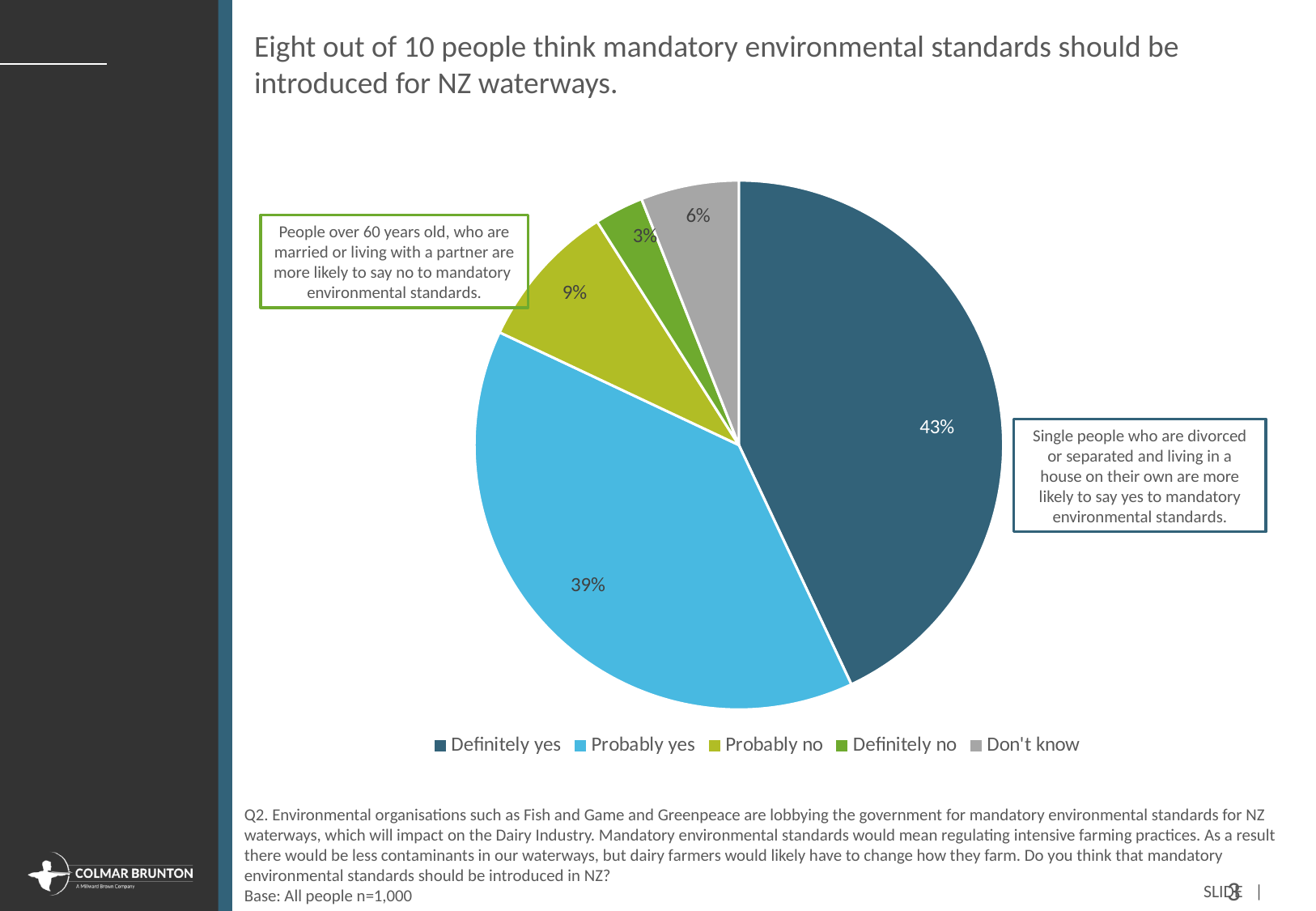
Which is larger: the share for 'Probably no' or the share for 'Don't know'? Probably no What percentage of people answered 'Don't know'? 6% Which response category has the largest share of the pie? Definitely yes How many response categories does the legend list? 5 What percentage of people said 'Probably yes'? 39% What percentage of people said 'Probably no'? 9% What is the difference in percentage points between 'Definitely yes' and 'Probably yes'? 4 percentage points What kind of chart is shown on the slide? Pie chart Which response category has the smallest share of the pie? Definitely no What percentage of people said 'Definitely no'? 3% What percentage of people said 'Definitely yes' to mandatory environmental standards? 43% What colour is the 'Probably yes' slice in the pie chart? Light blue